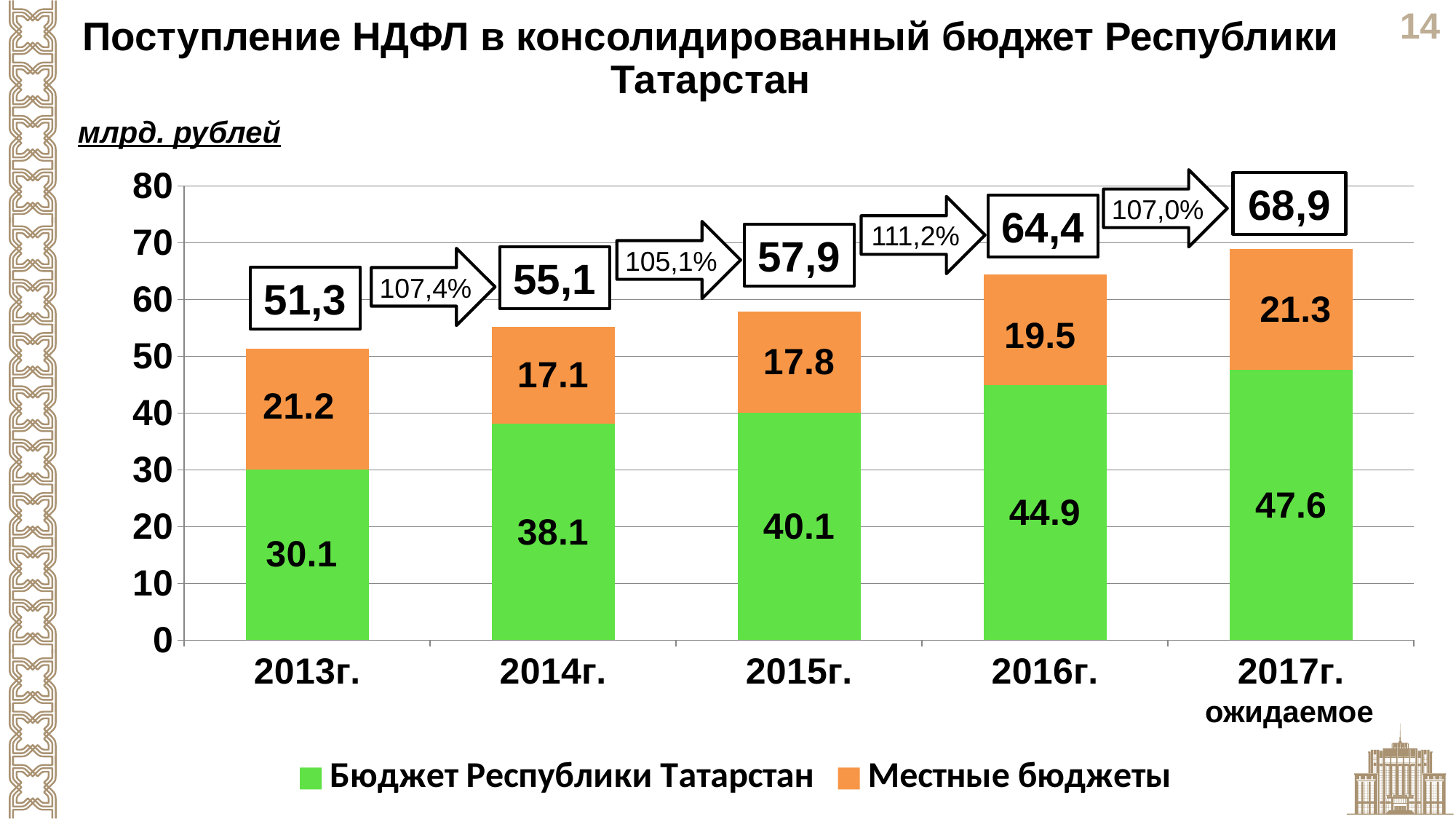
How many years are shown on the x axis? 5 What is the value for Местные бюджеты in 2016г.? 19.5 What is the total shown above the stacked bar for 2015г.? 57,9 Which year has the highest value for Бюджет Республики Татарстан? 2017г. What is the value for Бюджет Республики Татарстан in 2014г.? 38.1 Which year has the lowest value for Местные бюджеты? 2014г. Which is larger: Местные бюджеты in 2013г. or Местные бюджеты in 2015г.? 2013г. What growth percentage is shown in the arrow between 2015г. and 2016г.? 111,2% Do the total values rise or fall from 2013г. to 2017г.? Rise How many series does the legend list? 2 What kind of chart is shown on the slide? Stacked bar chart What is the difference between the Бюджет Республики Татарстан values for 2017г. and 2013г.? 17.5